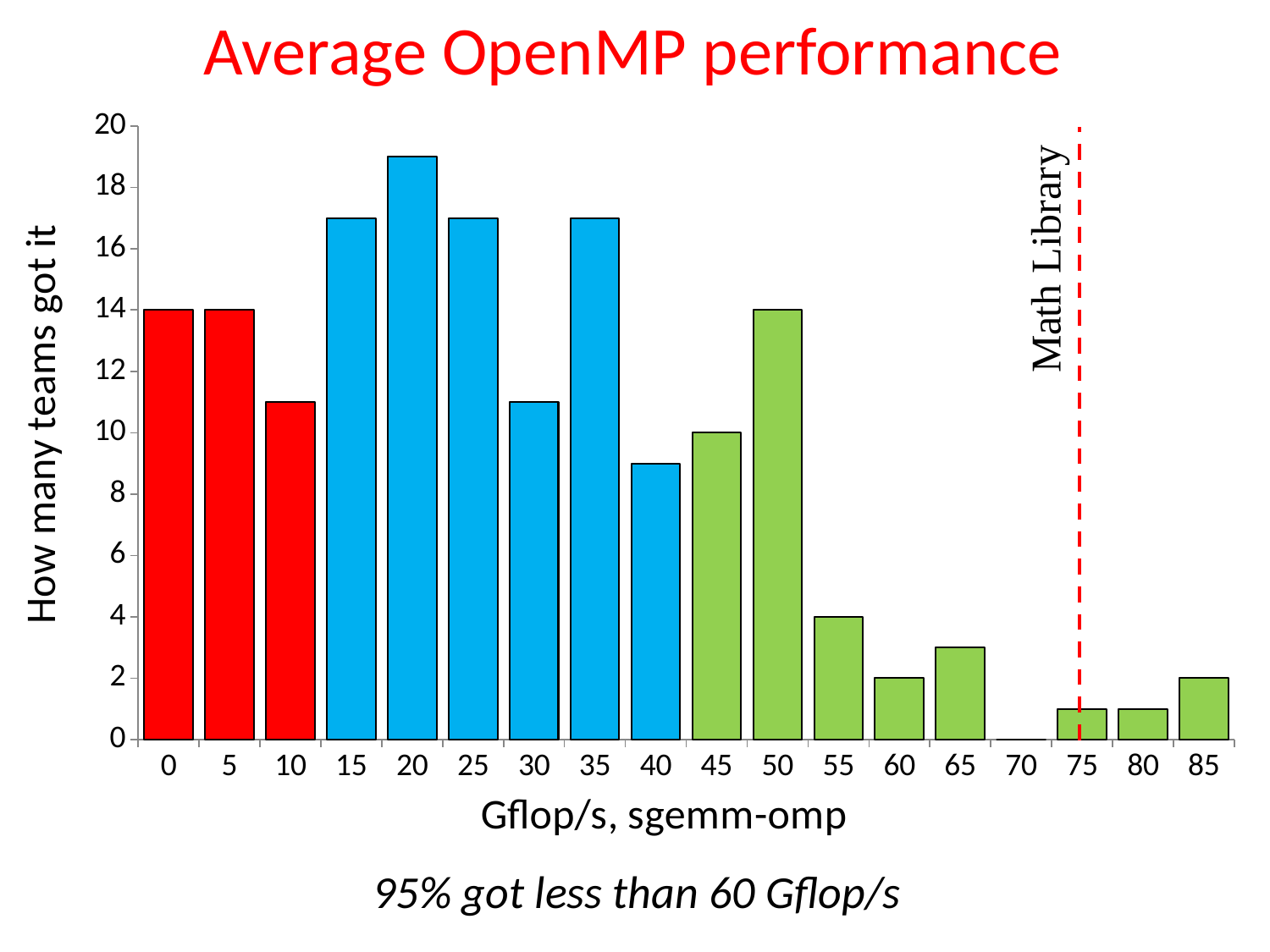
What is the title of the chart? Average OpenMP performance How many teams got 0 Gflop/s? 14 What is the difference between the number of teams at 0 Gflop/s and at 60 Gflop/s? 12 Which Gflop/s category has the lowest number of teams? 70 What type of chart is shown on the slide? bar chart Is the number of teams at 15 Gflop/s greater or less than 16? greater How many teams got 60 Gflop/s? 2 Which Gflop/s category has the highest number of teams? 20 What does the red dashed vertical line on the chart mark? Math Library Which has more teams, 20 Gflop/s or 40 Gflop/s? 20 Gflop/s How many teams got 55 Gflop/s? 4 How many teams got 50 Gflop/s? 14